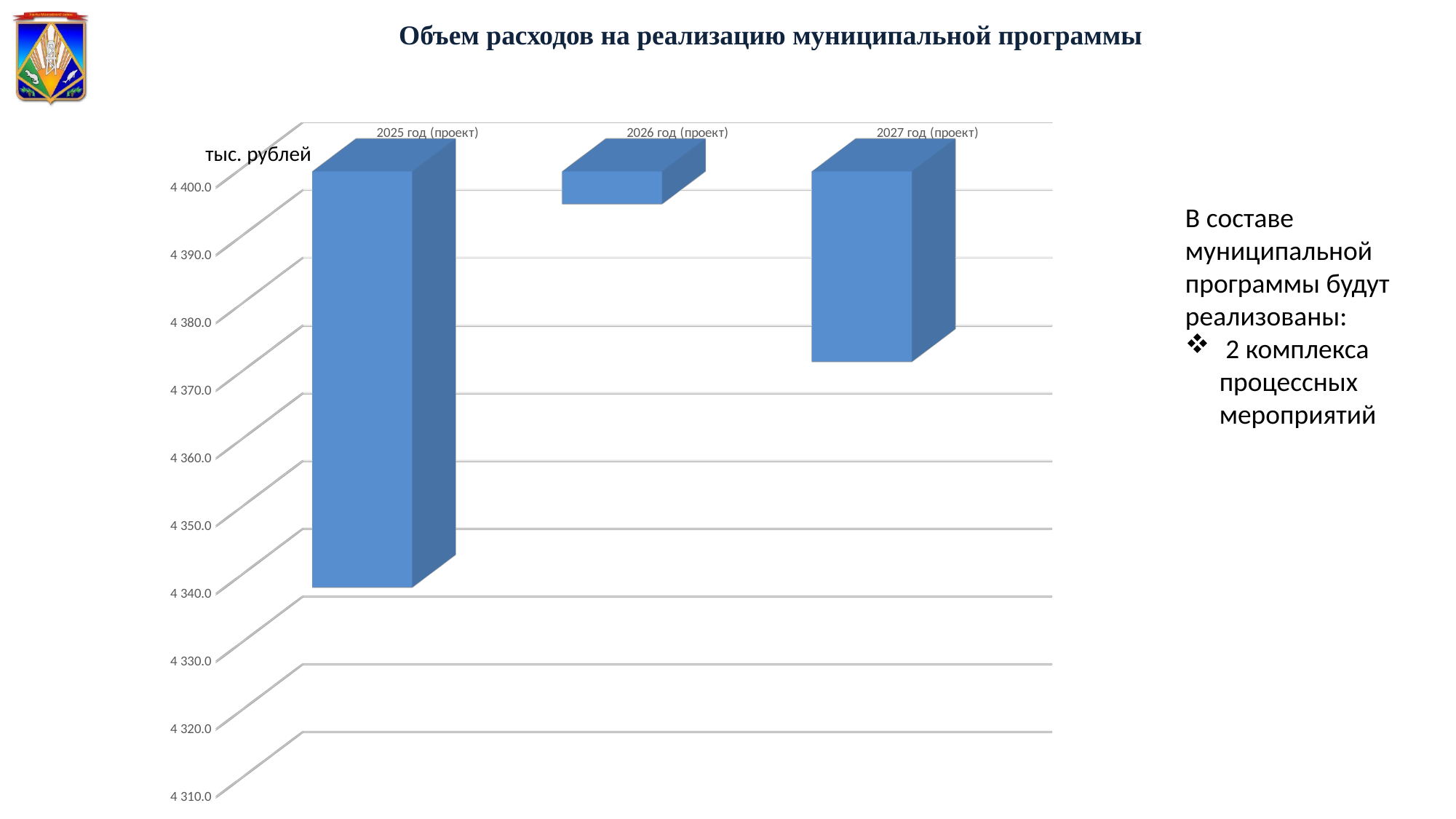
Which bar is taller: 2027 год (проект) or 2026 год (проект)? 2027 год (проект) Which category has the tallest bar in the chart? 2025 год (проект) In what units are the values on the vertical axis expressed, according to the label on the chart? тыс. рублей What kind of chart is shown on the slide? bar chart How many categories (years) are plotted in the chart? 3 What is the highest value shown on the vertical axis of the chart? 4 400.0 What is the title of the chart? Объем расходов на реализацию муниципальной программы What is the lowest value shown on the vertical axis of the chart? 4 310.0 Which category has the shortest bar in the chart? 2026 год (проект)